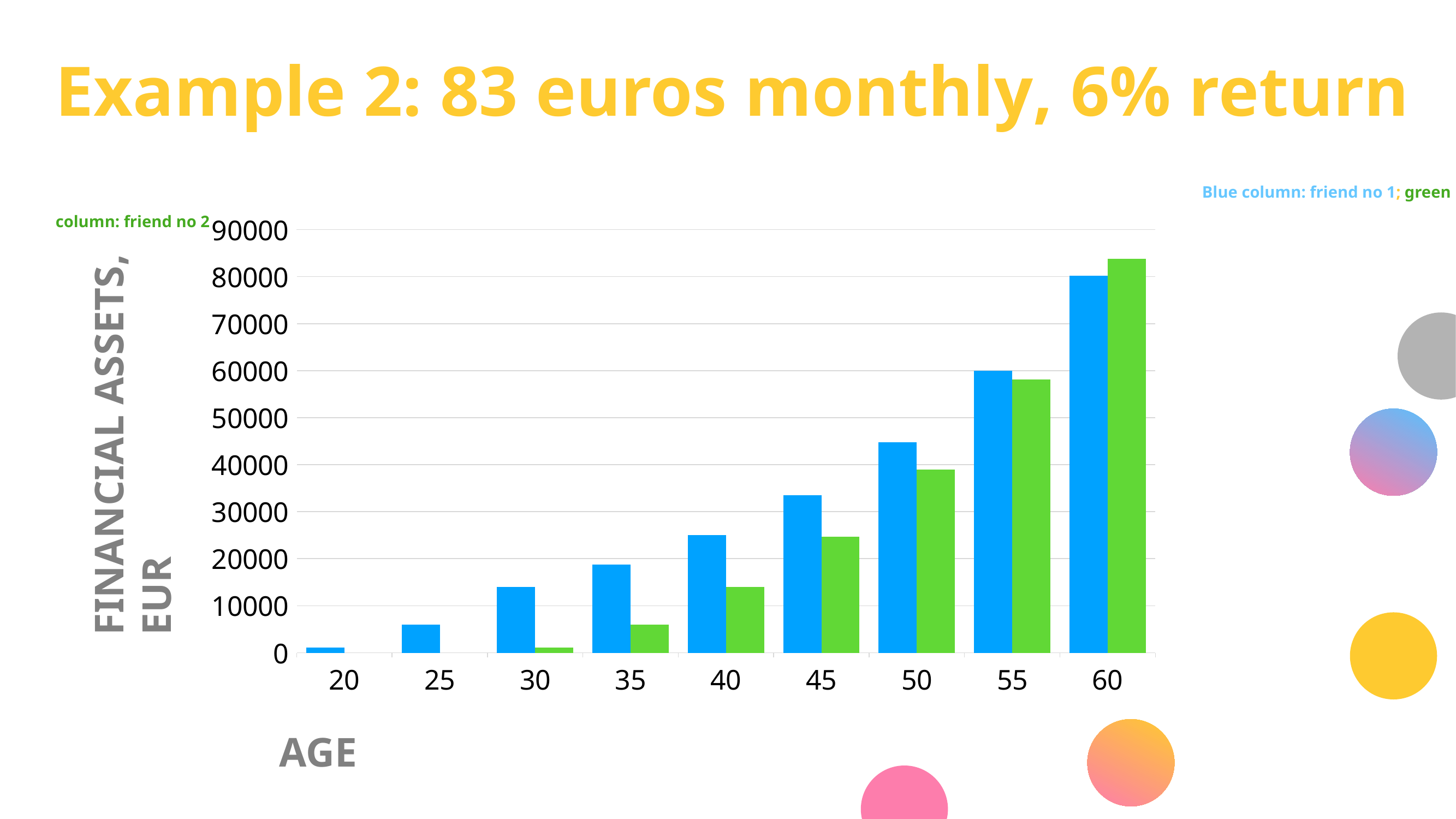
Is the value of the blue column at age 40 greater or less than 20000? greater At which age is the blue column (friend no 1) lowest? 20 Do the blue columns rise or fall as age increases? rise What is the title of the y axis? FINANCIAL ASSETS, EUR At which age is the blue column (friend no 1) highest? 60 How many age categories are shown on the x axis? 9 Is the value of the blue column at age 60 greater or less than 70000? greater Which friend does the blue column represent? friend no 1 At age 50, which column is larger, blue or green? blue Is the value of the green column at age 45 greater or less than 30000? less What kind of chart is shown on the slide? bar chart How many series does the chart plot? 2